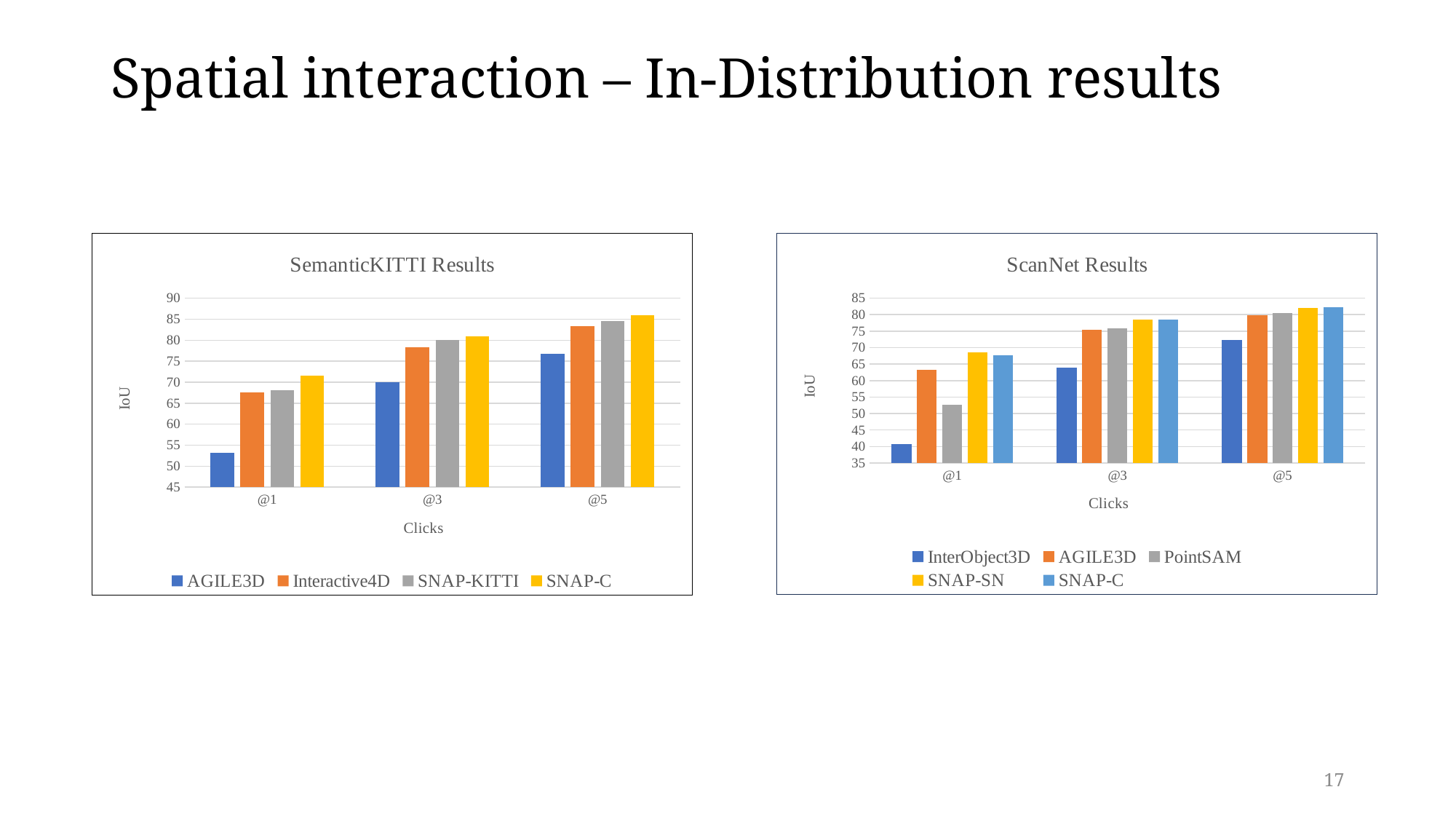
In the ScanNet Results chart, is the value for InterObject3D at @3 greater or less than 60? greater How many click categories are shown on the x axis of the ScanNet Results chart? 3 In the ScanNet Results chart, which series has the lowest value at @1? InterObject3D How many series does the legend of the SemanticKITTI Results chart list? 4 In the SemanticKITTI Results chart, is the value for SNAP-C at @5 greater or less than 80? greater In the ScanNet Results chart, which is larger at @1: AGILE3D or PointSAM? AGILE3D What kind of chart is the SemanticKITTI Results chart? bar chart In the ScanNet Results chart, which series has the lowest value at @5? InterObject3D In the SemanticKITTI Results chart, is the value for AGILE3D at @1 greater or less than 55? less What is the y-axis label of the SemanticKITTI Results chart? IoU How many series does the legend of the ScanNet Results chart list? 5 In the SemanticKITTI Results chart, do the AGILE3D values rise or fall from @1 to @5? rise